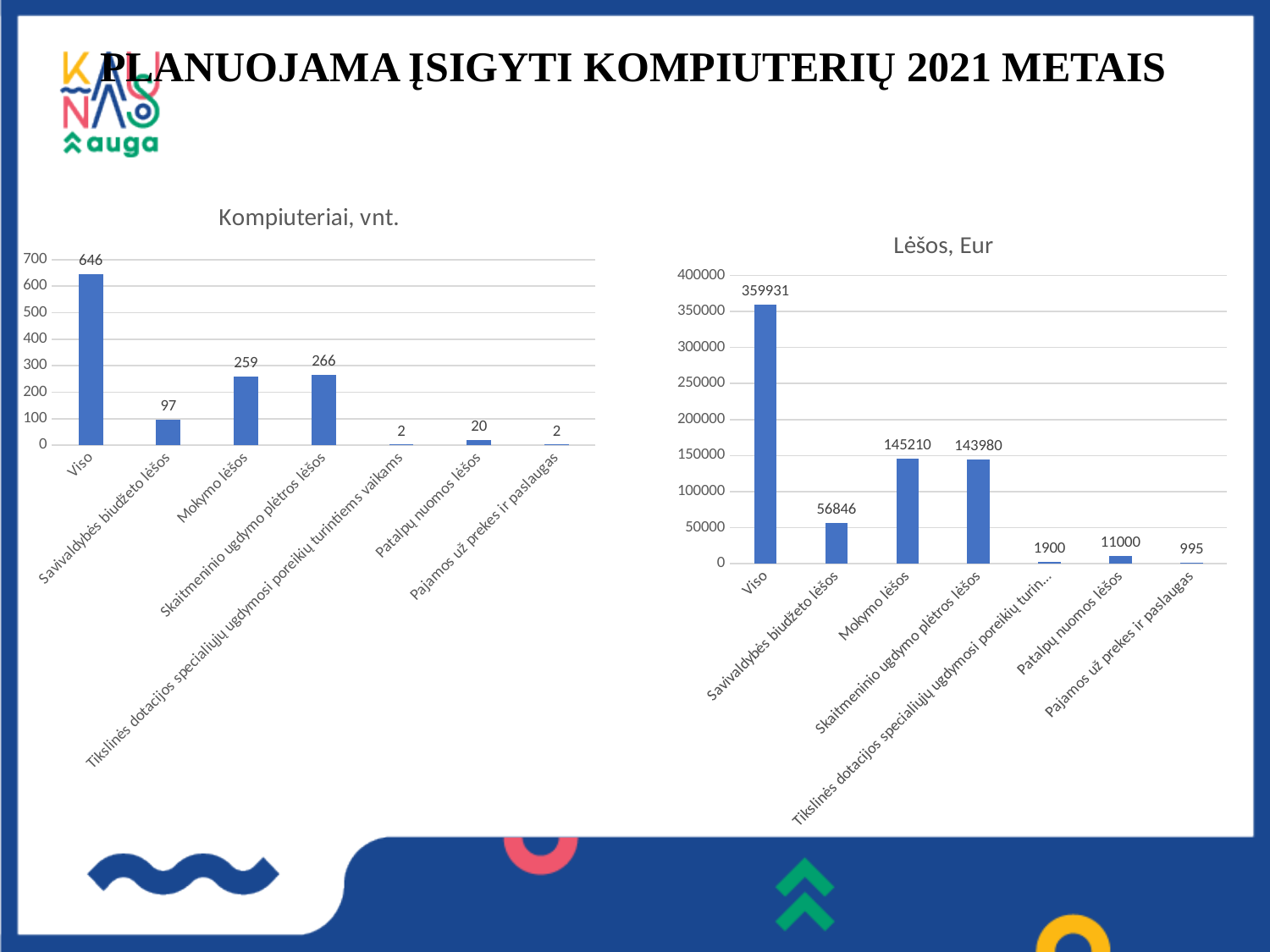
What type of chart is the "Lėšos, Eur" chart? Bar chart In the "Kompiuteriai, vnt." chart, what is the difference between Skaitmeninio ugdymo plėtros lėšos and Mokymo lėšos? 7 In the "Lėšos, Eur" chart, which is larger: Mokymo lėšos or Skaitmeninio ugdymo plėtros lėšos? Mokymo lėšos In the "Lėšos, Eur" chart, what is the difference between Mokymo lėšos and Skaitmeninio ugdymo plėtros lėšos? 1230 In the "Kompiuteriai, vnt." chart, how many categories are shown on the x axis? 7 What is the title of the chart on the left side of the slide? Kompiuteriai, vnt. In the "Kompiuteriai, vnt." chart, what is the value for Viso? 646 In the "Kompiuteriai, vnt." chart, which category other than Viso has the highest value? Skaitmeninio ugdymo plėtros lėšos In the "Kompiuteriai, vnt." chart, what is the value for Mokymo lėšos? 259 In the "Lėšos, Eur" chart, what is the value for Patalpų nuomos lėšos? 11000 In the "Lėšos, Eur" chart, which category has the lowest value? Pajamos už prekes ir paslaugas In the "Lėšos, Eur" chart, what is the value for Savivaldybės biudžeto lėšos? 56846